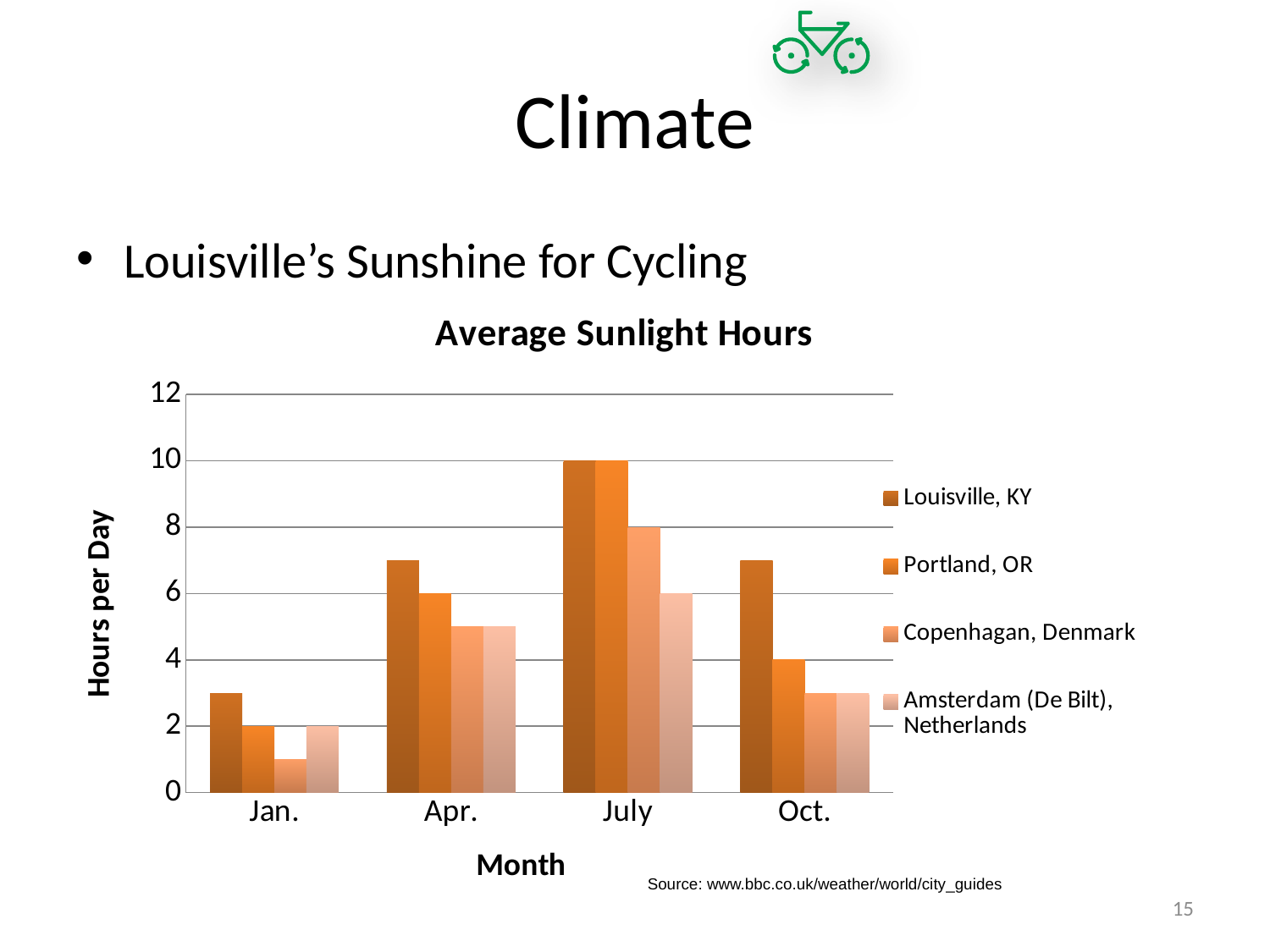
What type of chart is shown on the slide? bar chart Which is larger in Oct., Louisville, KY or Portland, OR? Louisville, KY What is the title of the chart? Average Sunlight Hours How many series does the legend list? 4 What is the value for Louisville, KY in July? 10 Is the value for Louisville, KY in Apr. greater or less than 6? greater In which month is the value for Louisville, KY highest? July What is the difference between Copenhagan, Denmark and Amsterdam (De Bilt), Netherlands in July? 2 In which month is the value for Portland, OR lowest? Jan. What is the value for Copenhagan, Denmark in July? 8 How many months are shown on the x axis? 4 What is the value for Portland, OR in Oct.? 4